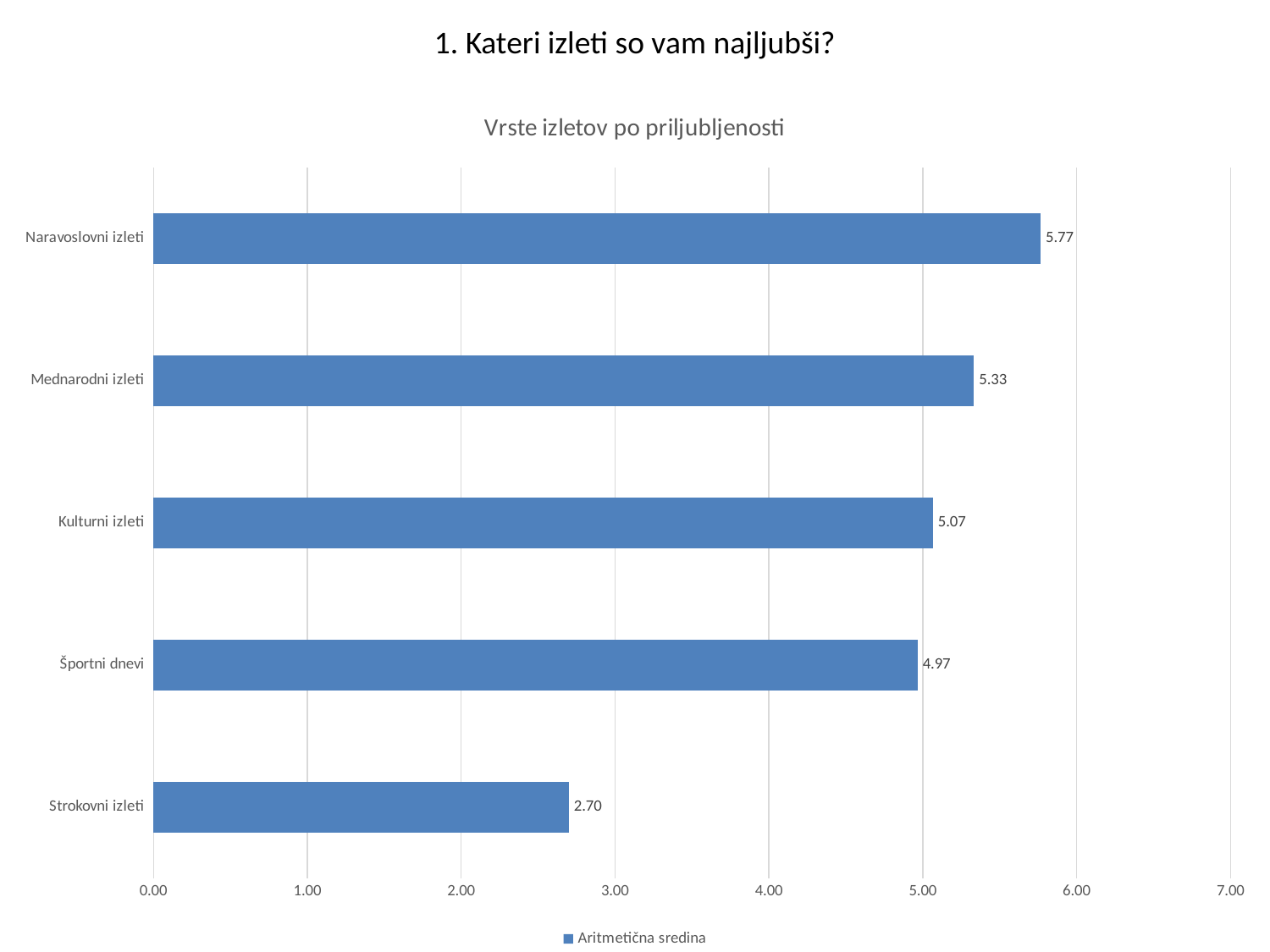
What is the value for Strokovni izleti? 2.70 Which category has the lowest value? Strokovni izleti Which is larger, the value for Mednarodni izleti or the value for Kulturni izleti? Mednarodni izleti What kind of chart is shown on the slide? bar chart Is the value for Športni dnevi greater or less than 5.00? less What is the difference between the values for Športni dnevi and Strokovni izleti? 2.27 How many categories are shown in the chart? 5 Which category has the highest value? Naravoslovni izleti What is the title of the chart? Vrste izletov po priljubljenosti What is the value for Naravoslovni izleti? 5.77 What is the value for Kulturni izleti? 5.07 What is the difference between the values for Naravoslovni izleti and Mednarodni izleti? 0.44